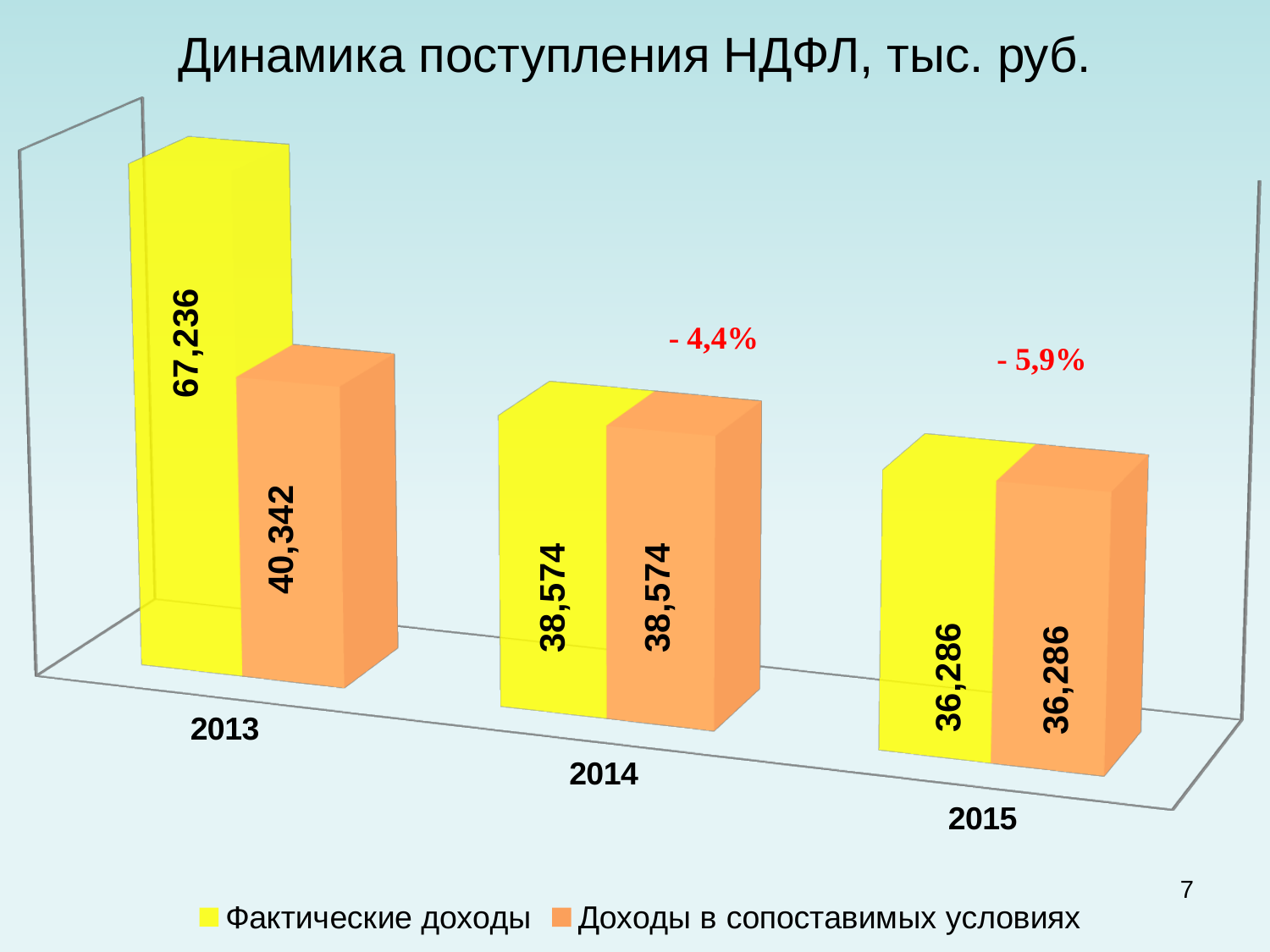
What is the value of Доходы в сопоставимых условиях for 2014? 38,574 Which year has the lowest value of Доходы в сопоставимых условиях? 2015 What is the value of Фактические доходы for 2015? 36,286 How many series does the legend list? 2 What is the difference between Фактические доходы and Доходы в сопоставимых условиях in 2013? 26,894 What is the difference between Фактические доходы in 2014 and in 2015? 2,288 What is the value of Фактические доходы for 2013? 67,236 How many years are shown on the x axis? 3 Which is larger: Фактические доходы in 2013 or Фактические доходы in 2014? 2013 What is the value of Доходы в сопоставимых условиях for 2013? 40,342 What kind of chart is shown on the slide? Bar chart Which year has the highest value of Фактические доходы? 2013